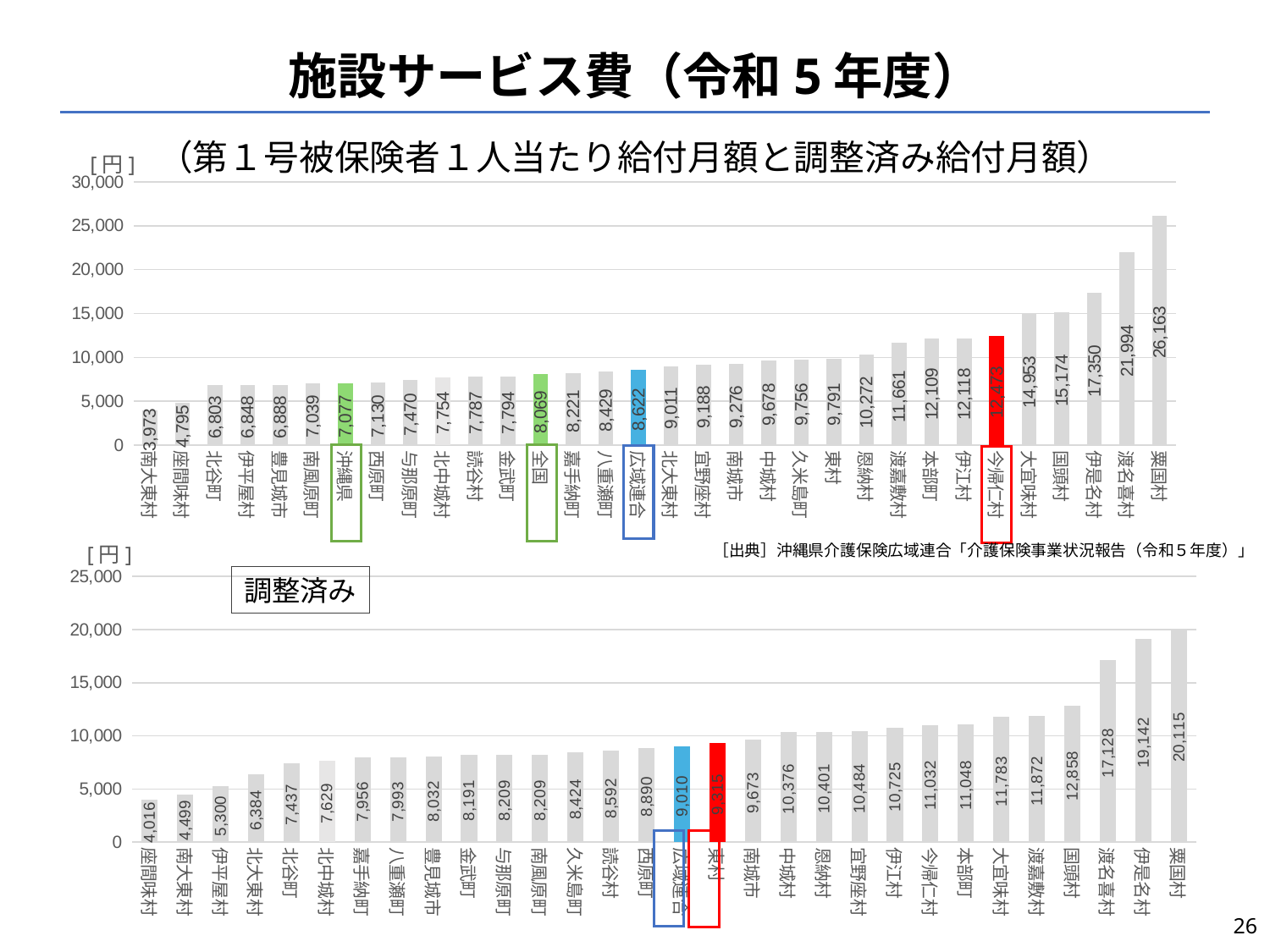
In the bottom chart (調整済み), what is the value for 広域連合? 9,010 In the top chart, is the value for 渡名喜村 greater or less than 20,000? greater In the bottom chart (調整済み), which is larger, the value for 国頭村 or the value for 渡嘉敷村? 国頭村 In the top chart, what is the difference between 広域連合 (8,622) and 全国 (8,069)? 553 In the top chart, which category has the highest value? 粟国村 In the top chart (第1号被保険者1人当たり給付月額), what is the value for 沖縄県? 7,077 In the bottom chart (調整済み), what is the value for 東村? 9,315 In the top chart, what is the value for 全国? 8,069 In the bottom chart (調整済み), how many categories are plotted? 30 In the top chart, which category has the lowest value? 南大東村 What type of chart is the top chart? bar chart In the bottom chart (調整済み), which category has the highest value? 粟国村